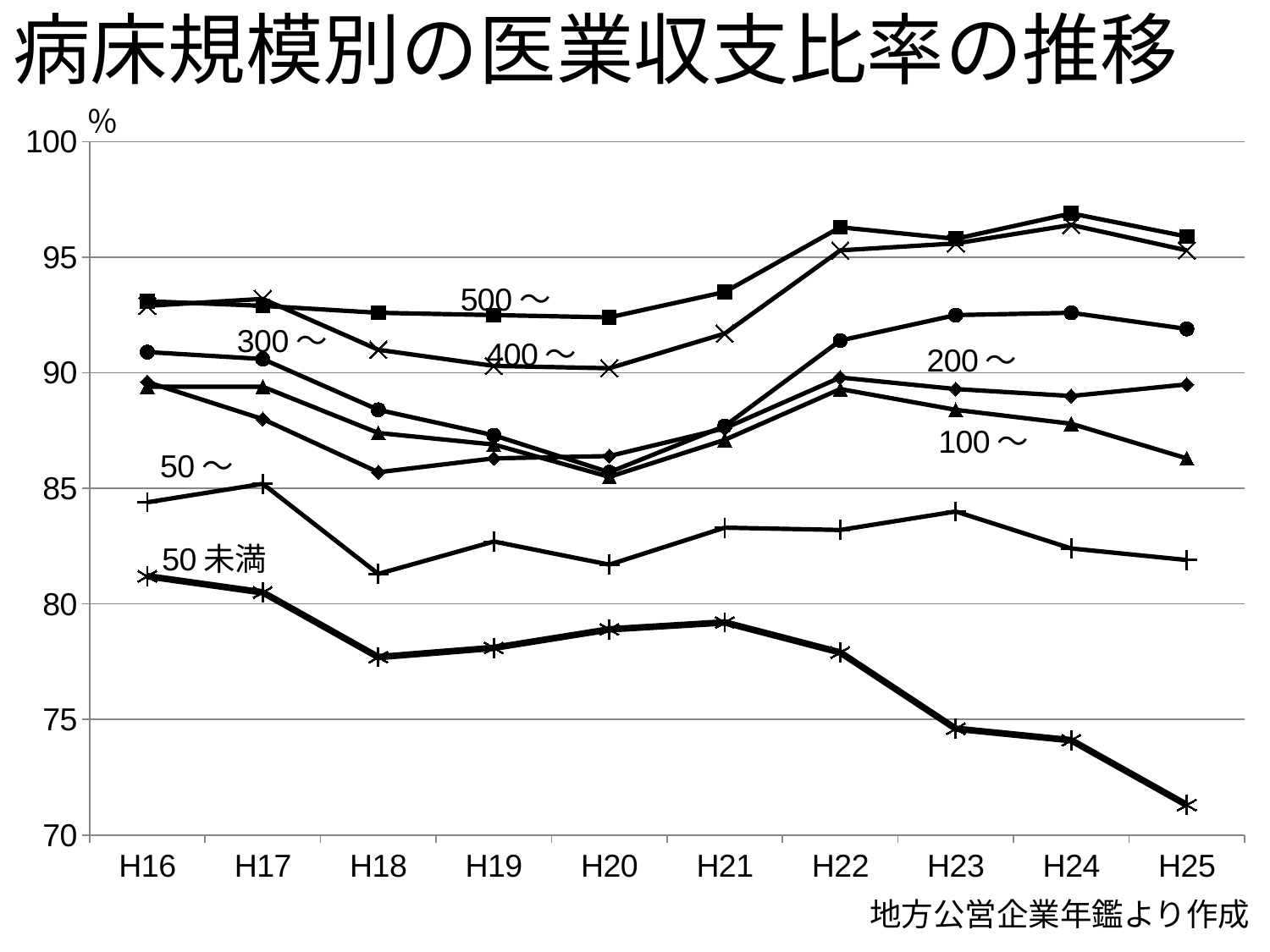
Is the value for 500～ at H24 greater or less than 95? greater How many years (points) are shown along the x axis? 10 Which series has the highest value at H18? 500～ What kind of chart is shown on the slide? line chart Which series has the lowest value at H25? 50未満 How many series (bed-size groups) are labelled on the chart? 7 Is the value for 50～ at H18 greater or less than 80? greater Does the 500～ line rise or fall from H20 to H24? rise At H22, which is larger: the value for 300～ or the value for 200～? 300～ Is the value for 50未満 at H25 greater or less than 75? less Does the 50未満 line rise or fall from H21 to H25? fall